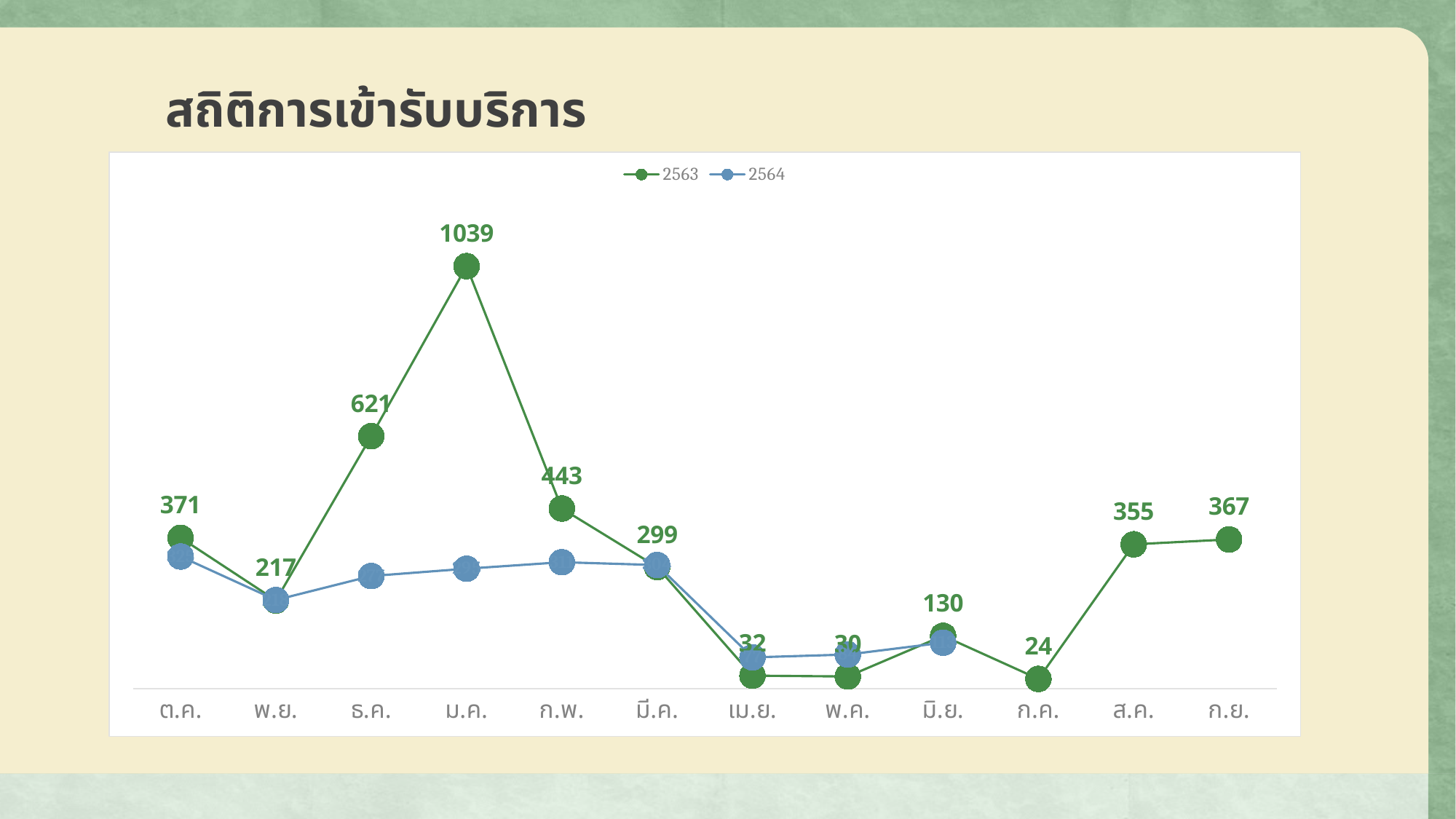
How many months are shown on the x axis? 12 In which month is the 2563 series lowest? ก.ค. Which series has the higher value in ม.ค., 2563 or 2564? 2563 Does the 2563 series rise or fall from ธ.ค. to ม.ค.? rise What is the value for 2563 in ม.ค.? 1039 In which month is the 2563 series highest? ม.ค. How many series does the legend list? 2 What is the value for 2563 in ธ.ค.? 621 What kind of chart is shown on the slide? line chart What is the difference between the 2563 values for ม.ค. and ธ.ค.? 418 What is the value for 2563 in ก.ย.? 367 What is the value for 2563 in ก.ค.? 24